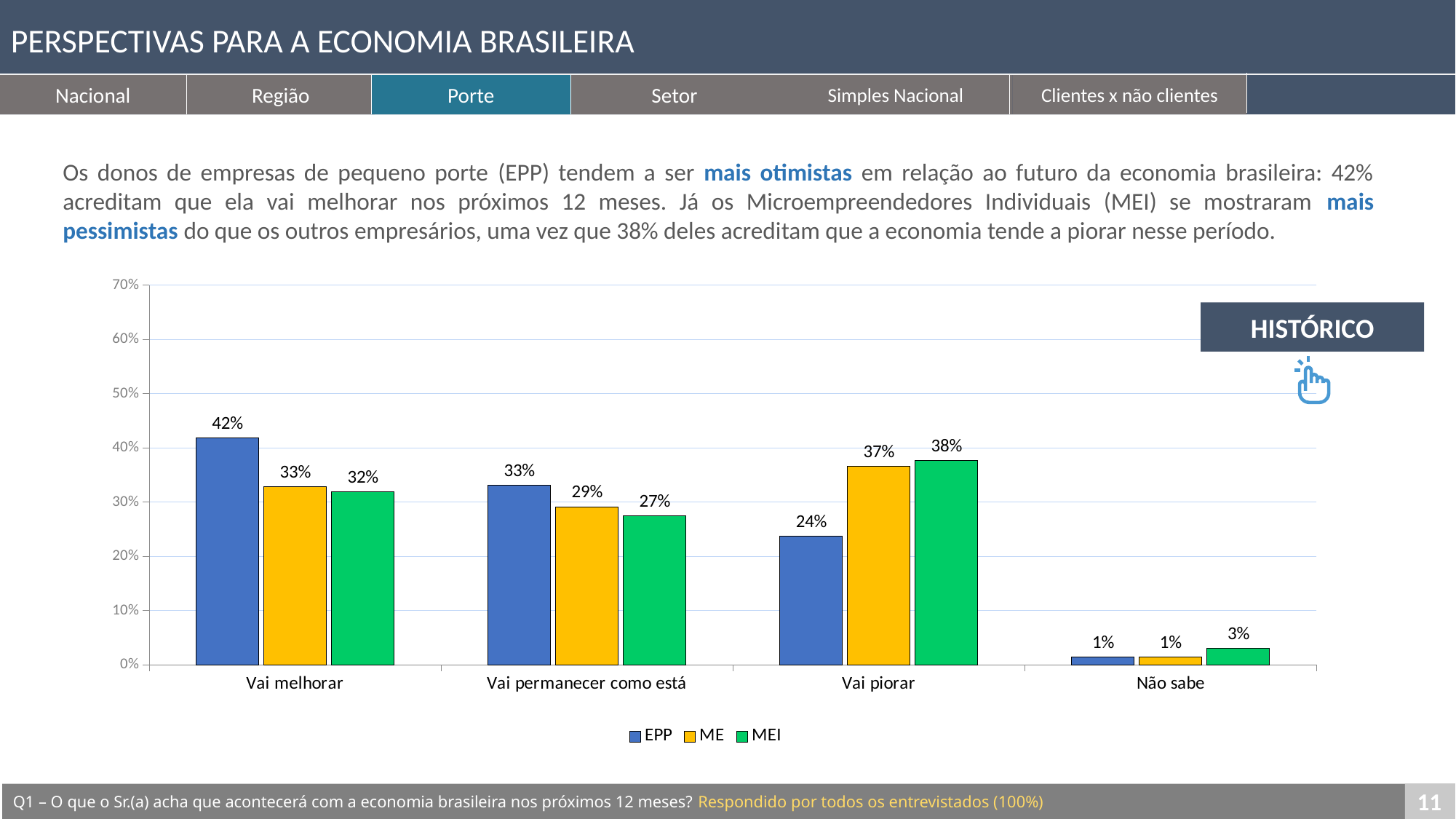
What is the difference between the EPP and MEI values in the 'Vai melhorar' category? 10% What is the value for ME in the 'Vai permanecer como está' category? 29% What is the value for EPP in the 'Vai melhorar' category? 42% Which series has the highest value in the 'Vai melhorar' category? EPP How many series does the legend list? 3 What is the value for MEI in the 'Não sabe' category? 3% What colour are the bars for the MEI series? Green What kind of chart is shown on the slide? Bar chart What is the value for MEI in the 'Vai piorar' category? 38% Which is larger: the ME value for 'Vai piorar' or the ME value for 'Vai melhorar'? Vai piorar Which series has the lowest value in the 'Vai piorar' category? EPP How many categories are shown on the x axis? 4